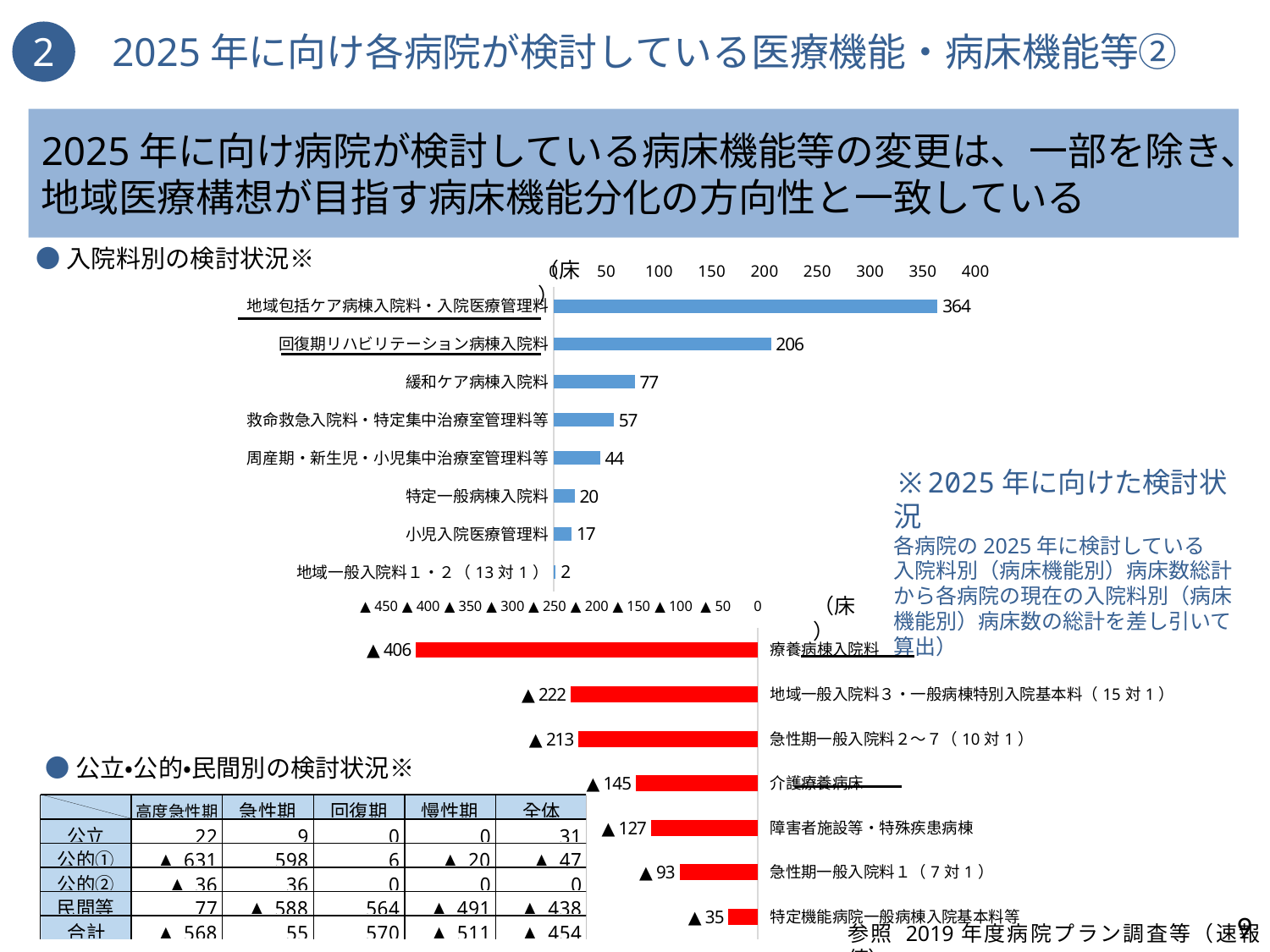
In the lower red bar chart, what is the value for 療養病棟入院料? ▲406 In the upper blue bar chart, what is the value for 緩和ケア病棟入院料? 77 In the lower red bar chart, which category has the largest decrease? 療養病棟入院料 In the upper blue bar chart, which category has the highest value? 地域包括ケア病棟入院料・入院医療管理料 In the lower red bar chart, which category has the smallest decrease? 特定機能病院一般病棟入院基本料等 What type of chart is used for the 入院料別の検討状況 data on this slide? Bar chart In the upper blue bar chart, how many categories are plotted? 8 In the upper blue bar chart, what is the value for 地域包括ケア病棟入院料・入院医療管理料? 364 In the upper blue bar chart, what is the difference between 地域包括ケア病棟入院料・入院医療管理料 and 回復期リハビリテーション病棟入院料? 158 In the upper blue bar chart, which category has the lowest value? 地域一般入院料１・２（13対1） In the lower red bar chart, what is the value for 急性期一般入院料１（7対1）? ▲93 In the lower red bar chart, how many categories are plotted? 7